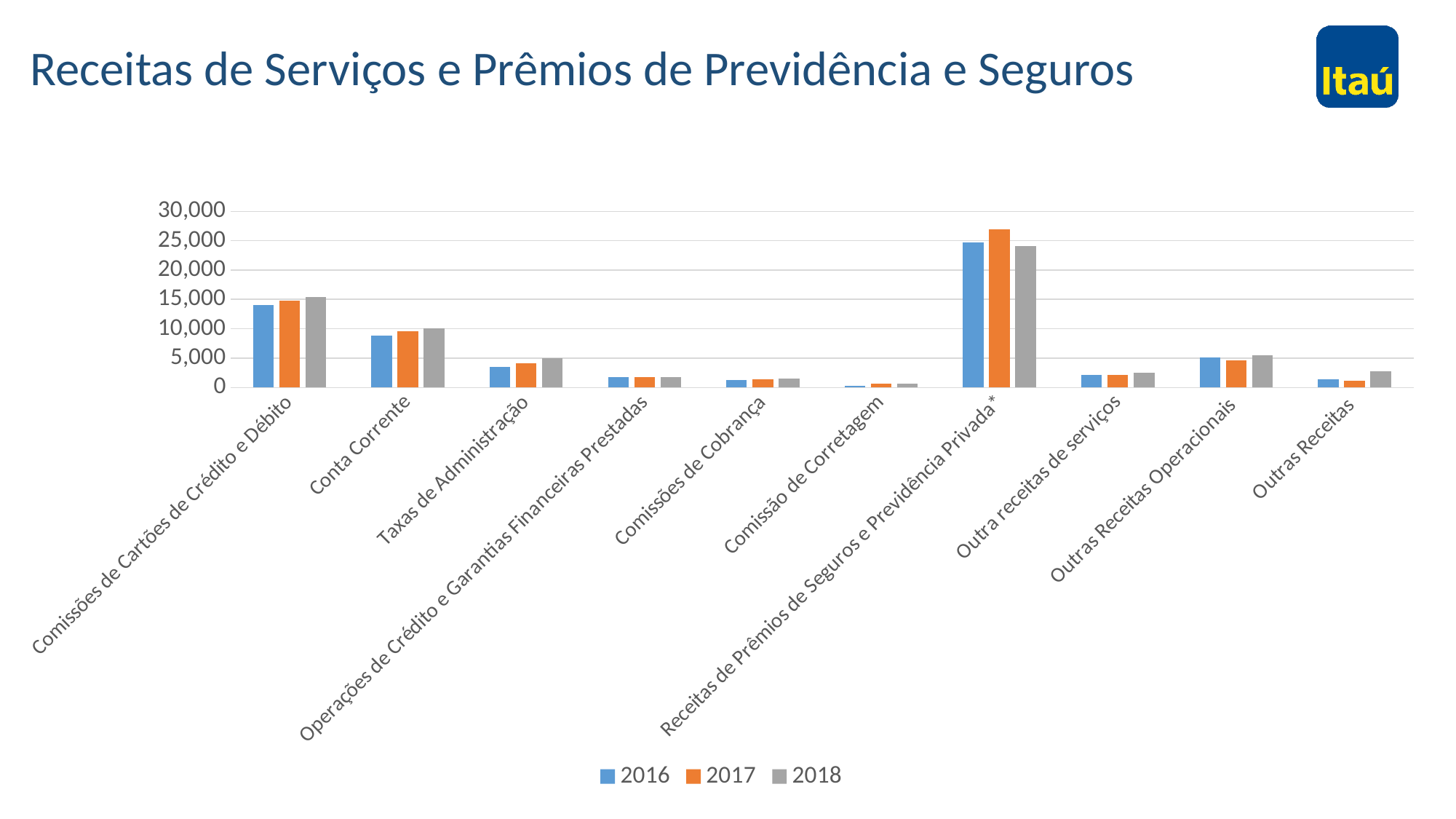
What kind of chart is shown on the slide? bar chart How many series does the legend list? 3 Which category has the highest values across all three years? Receitas de Prêmios de Seguros e Previdência Privada* Is the 2016 value for Conta Corrente greater or less than 10,000? less Is the 2016 value for Comissões de Cartões de Crédito e Débito greater or less than 15,000? less Is the 2017 value for Receitas de Prêmios de Seguros e Previdência Privada* greater or less than 25,000? greater For Comissões de Cartões de Crédito e Débito, do the values rise or fall from 2016 to 2018? rise For Receitas de Prêmios de Seguros e Previdência Privada*, which year has the larger value, 2017 or 2018? 2017 How many categories are shown on the x axis? 10 Which category has the lowest values across all three years? Comissão de Corretagem What colour represents the 2017 series in the legend? orange